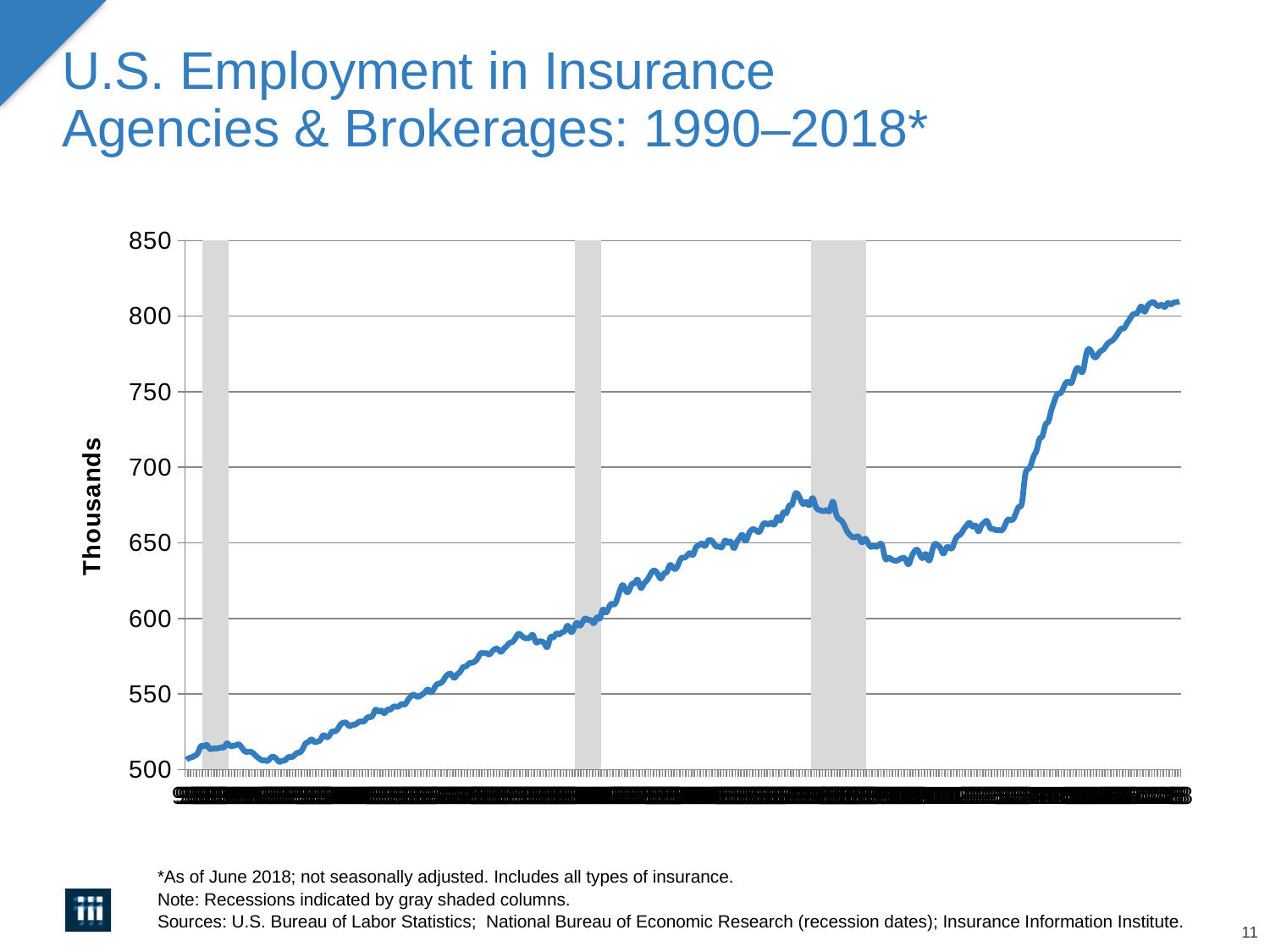
Is the value at the start of the series (left end of the line) greater or less than 550? less Is the highest value of the series at the beginning or at the end of the period? end Which is larger: the value at the right end of the line or the value at the left end of the line? right end Is the value at the end of the series (right end of the line) greater or less than 800? greater What kind of chart is shown on the slide? line chart Is the lowest value reached after the third gray shaded column greater or less than 600? greater What is the label on the vertical axis of the chart? Thousands What is the title of the chart on the slide? U.S. Employment in Insurance Agencies & Brokerages: 1990–2018* What is the lowest value shown on the vertical axis? 500 Overall, do the values rise or fall from the left to the right of the chart? rise